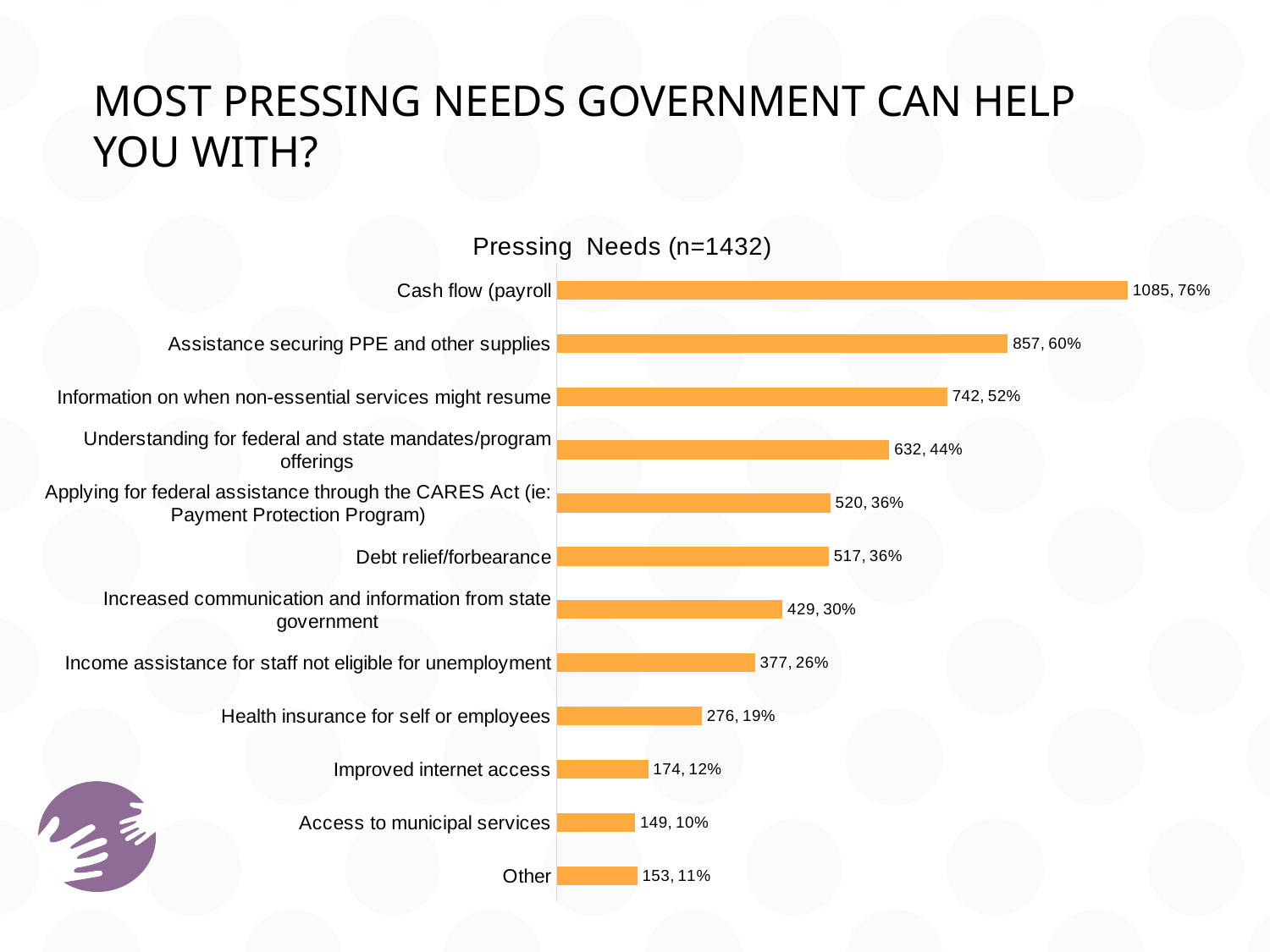
What percentage is shown for Debt relief/forbearance? 36% Which category has the lowest count? Access to municipal services What is the title of the chart? Pressing Needs (n=1432) What is the difference in count between Other and Access to municipal services? 4 What percentage is shown for Assistance securing PPE and other supplies? 60% What is the count for Improved internet access? 174 What is the difference in count between Cash flow (payroll) and Assistance securing PPE and other supplies? 228 Which has a higher count: Health insurance for self or employees or Income assistance for staff not eligible for unemployment? Income assistance for staff not eligible for unemployment How many categories are shown in the chart? 12 What is the count for Cash flow (payroll)? 1085 Which category has the highest count? Cash flow (payroll) What kind of chart is this? Bar chart